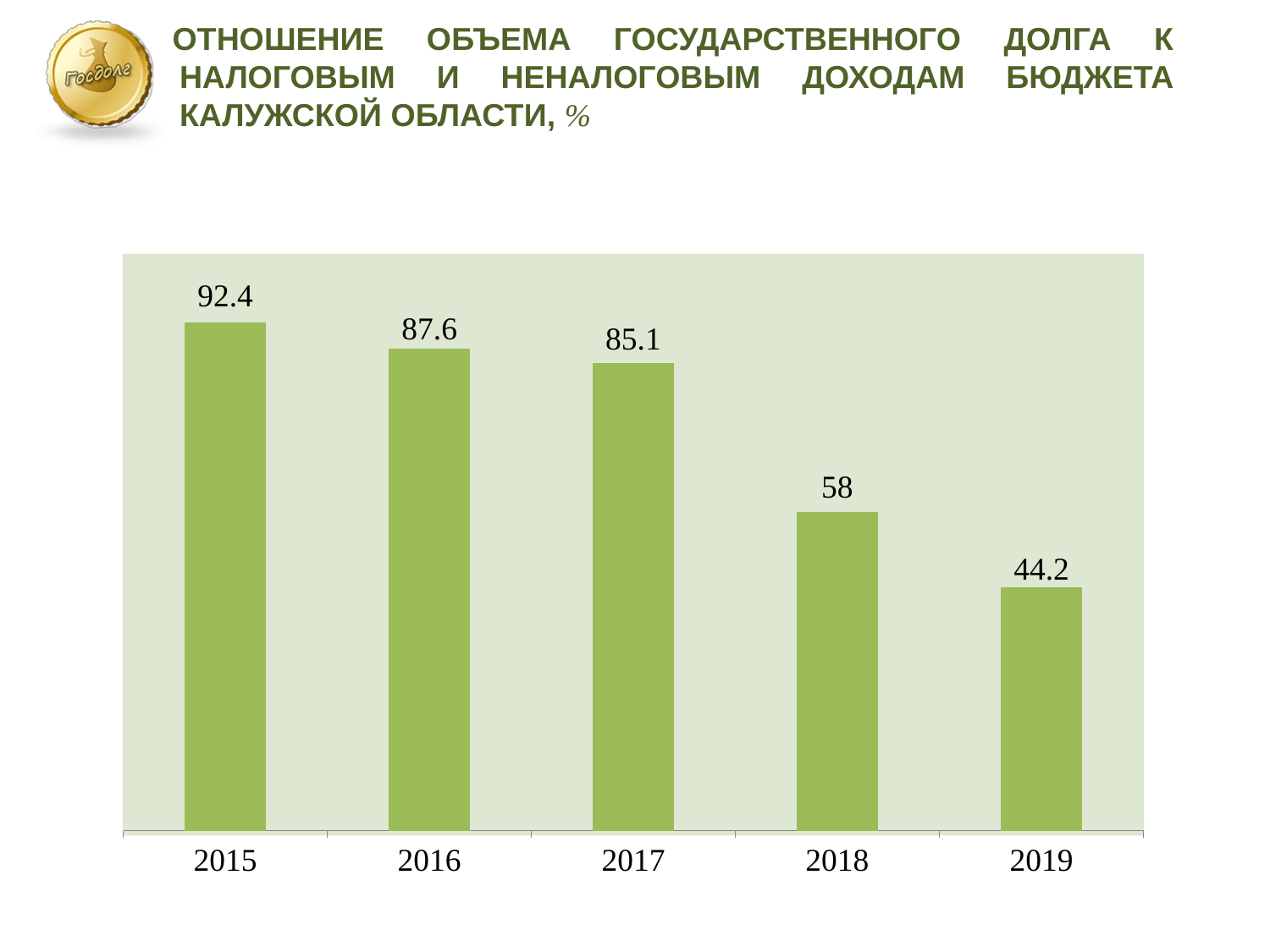
Which year has the lowest value? 2019 Which year has the highest value? 2015 How many years are shown on the x axis? 5 What unit is given in the chart title? % What is the difference between the values for 2015 and 2019? 48.2 Do the values rise or fall from 2015 to 2019? fall What is the difference between the values for 2017 and 2018? 27.1 Which is larger, the value for 2016 or the value for 2018? 2016 What is the value for 2015? 92.4 What is the value for 2017? 85.1 What kind of chart is this? bar chart What is the value for 2019? 44.2